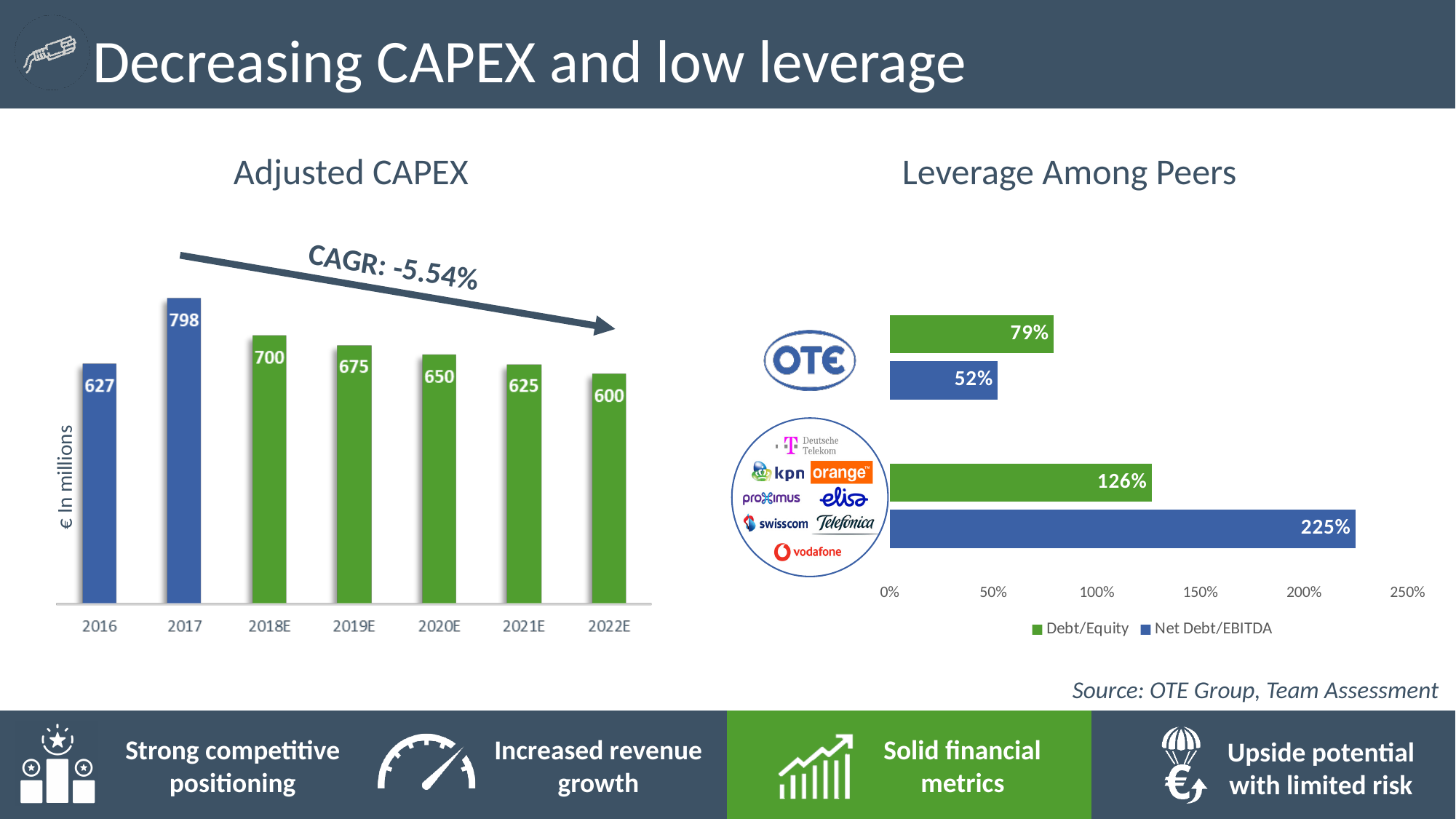
In the Adjusted CAPEX chart, how many years are shown on the x axis? 7 In the Leverage Among Peers chart, how many series does the legend list? 2 In the Adjusted CAPEX chart, which year has the lowest value? 2022E In the Adjusted CAPEX chart, what is the value for 2017? 798 In the Adjusted CAPEX chart, do the values rise or fall from 2018E to 2022E? fall In the Leverage Among Peers chart, what is the Debt/Equity value for the peer group? 126% In the Leverage Among Peers chart, what is the difference between the peer group's Net Debt/EBITDA and OTE's Net Debt/EBITDA? 173% In the Adjusted CAPEX chart, which year has the highest value? 2017 In the Leverage Among Peers chart, what is the Net Debt/EBITDA value for OTE? 52% What kind of chart is the Leverage Among Peers chart? bar chart In the Adjusted CAPEX chart, what is the difference between the 2017 and 2016 values? 171 In the Adjusted CAPEX chart, what is the value for 2022E? 600